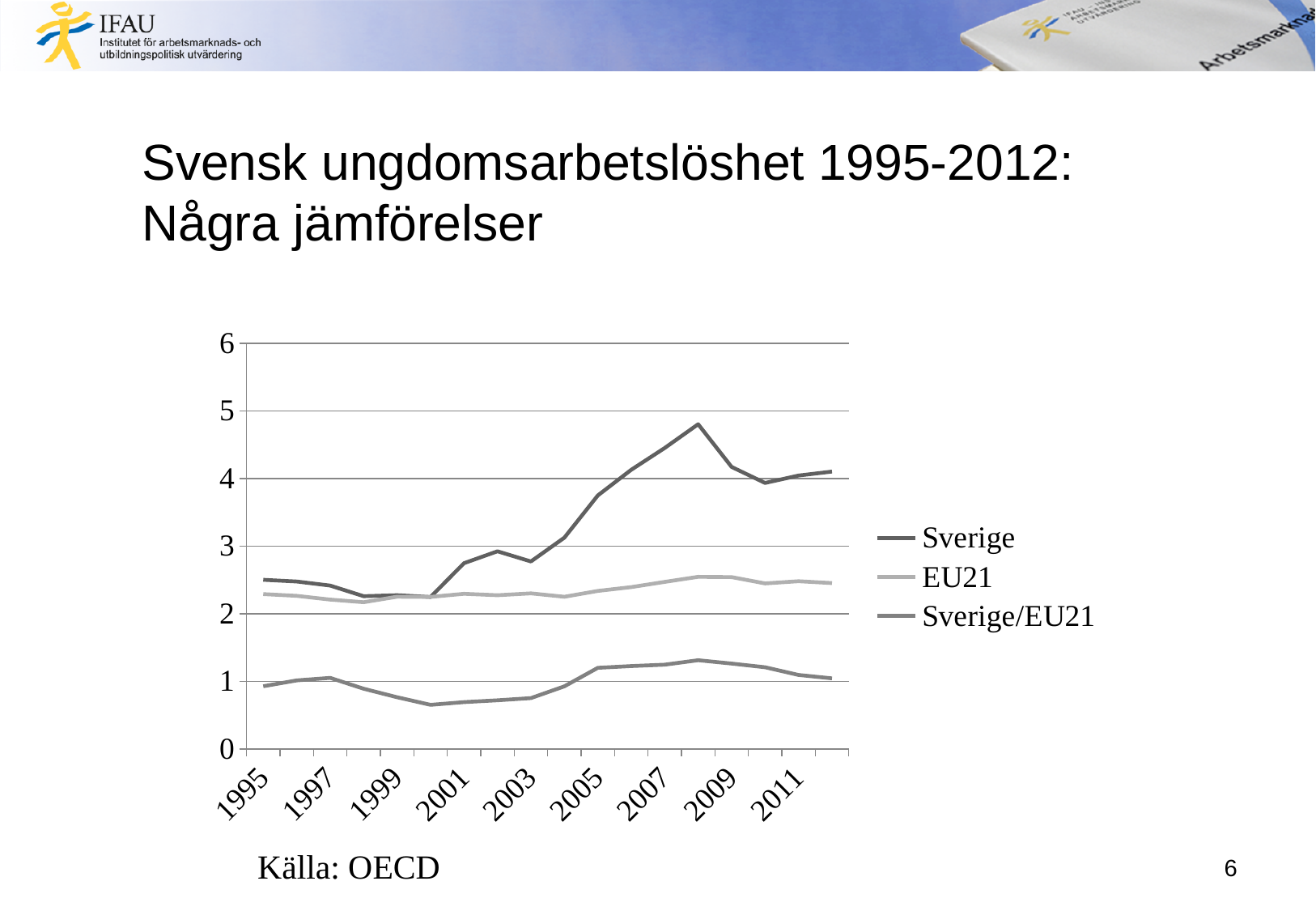
In 2008, which series has the larger value, Sverige or EU21? Sverige In which year does the Sverige line reach its highest value? 2008 How many series does the legend list? 3 Is the value for EU21 in 1995 greater or less than 2? greater In which year does the Sverige/EU21 line reach its lowest value? 2000 What kind of chart is shown on the slide? line chart Does the Sverige line rise or fall between 2001 and 2008? rise Is the value for Sverige in 2008 greater or less than 4? greater Is the value for Sverige/EU21 in 2000 greater or less than 1? less What are the three series named in the legend? Sverige, EU21, Sverige/EU21 What source is cited below the chart? Källa: OECD